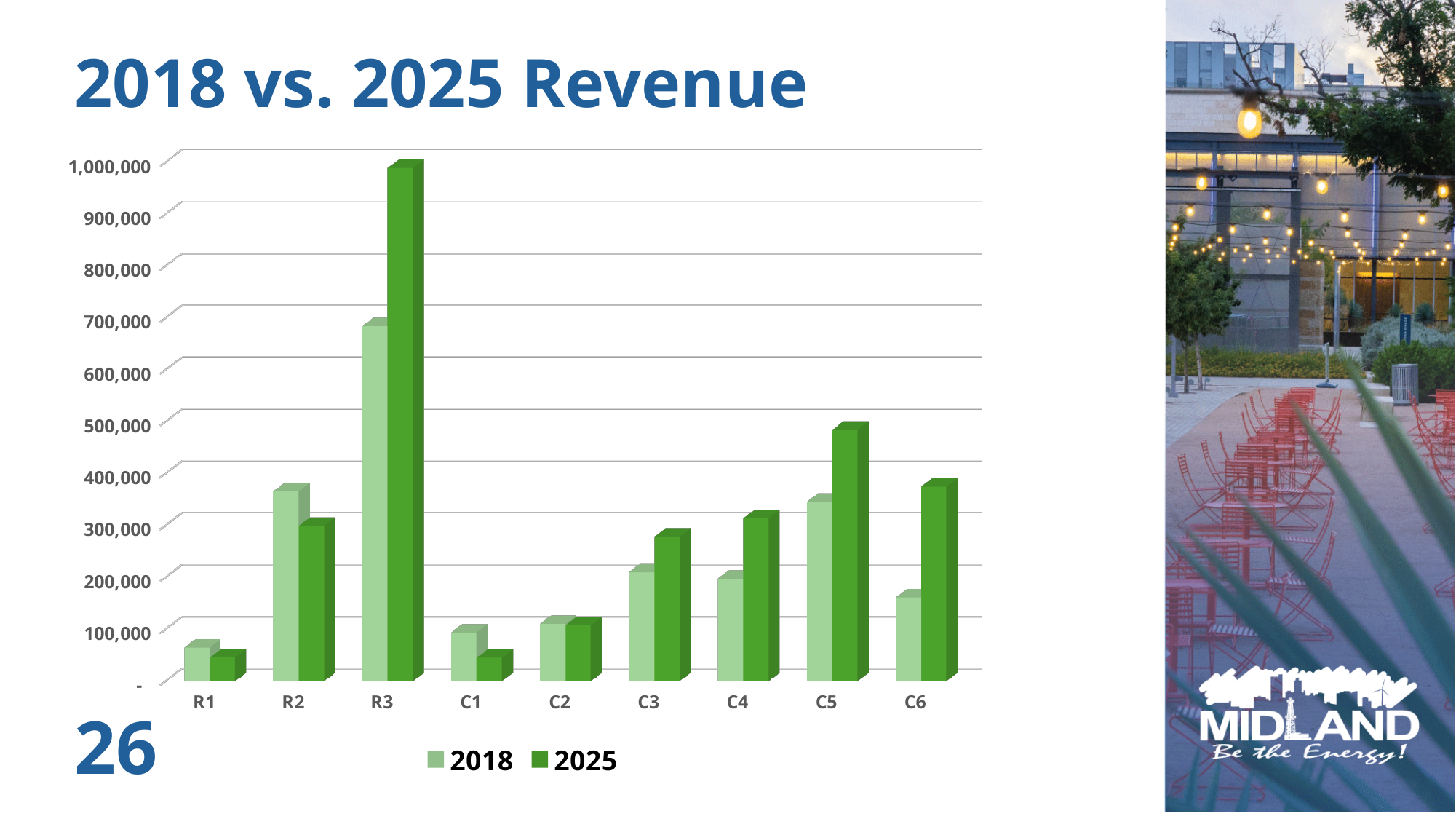
For R2, which series has the larger value, 2018 or 2025? 2018 What is the title of the chart? 2018 vs. 2025 Revenue Is the 2025 value for C1 greater or less than 100,000? less Which category has the highest 2025 revenue? R3 Which category has the lowest 2018 revenue? R1 How many series does the legend list? 2 Is the 2025 value for R3 greater or less than 900,000? greater For C6, which series has the larger value, 2018 or 2025? 2025 What kind of chart is shown on the slide? bar chart Is the 2018 value for R2 greater or less than 300,000? greater How many categories are shown on the x axis of the chart? 9 Which category has the highest 2018 revenue? R3